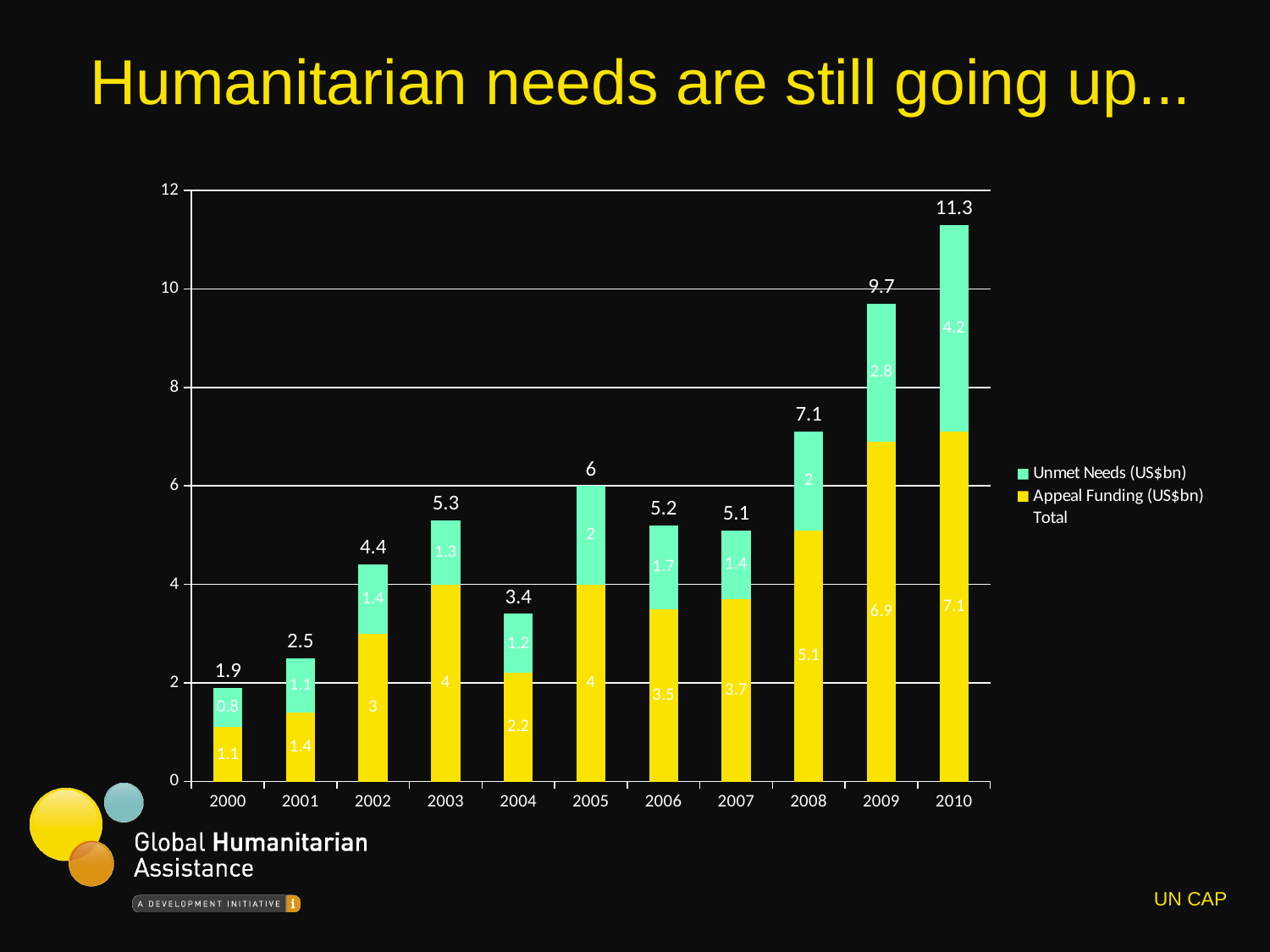
Which year has the lowest total? 2000 How many entries does the legend list? 3 Which is larger, the Appeal Funding value for 2003 or the Appeal Funding value for 2004? 2003 What is the Appeal Funding (US$bn) value for 2010? 7.1 Is the total for 2008 greater or less than 8? less What kind of chart is shown on the slide? Stacked bar chart What is the title of the slide? Humanitarian needs are still going up... Which year has the highest total? 2010 What is the difference between the total for 2010 and the total for 2009? 1.6 How many years are shown on the x axis? 11 What is the total value shown above the bar for 2005? 6 What is the Unmet Needs (US$bn) value for 2009? 2.8